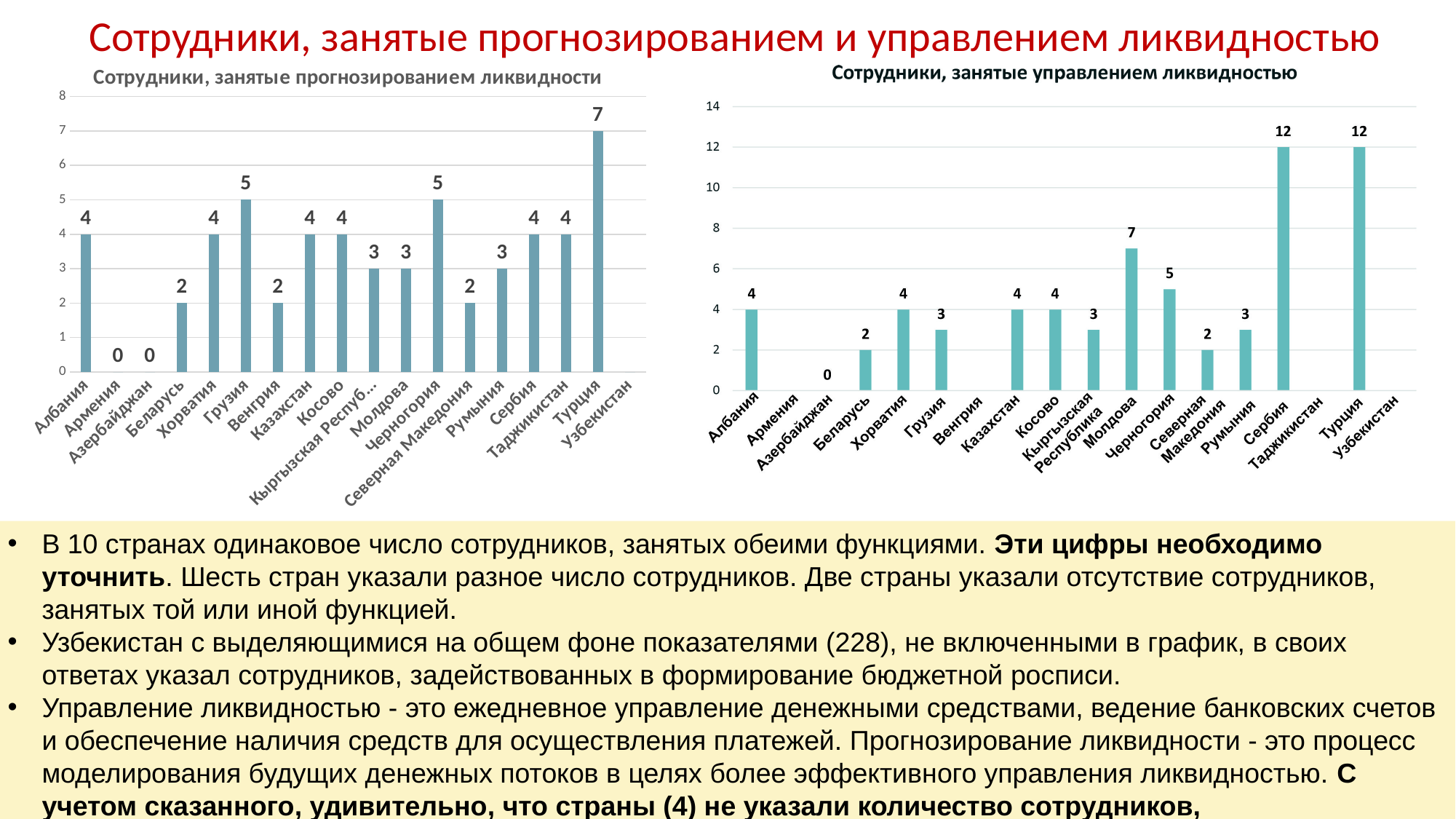
In the chart 'Сотрудники, занятые прогнозированием ликвидности', which country has the highest value? Турция In the chart 'Сотрудники, занятые управлением ликвидностью', what is the difference between the values for Турция and Черногория? 7 How many countries are listed on the x axis of the chart 'Сотрудники, занятые управлением ликвидностью'? 18 In the chart 'Сотрудники, занятые прогнозированием ликвидности', what is the value for Грузия? 5 In the chart 'Сотрудники, занятые прогнозированием ликвидности', which is larger: the value for Беларусь or the value for Молдова? Молдова What type of chart is 'Сотрудники, занятые управлением ликвидностью'? Bar chart In the chart 'Сотрудники, занятые управлением ликвидностью', what is the value for Молдова? 7 In the chart 'Сотрудники, занятые управлением ликвидностью', what is the value for Сербия? 12 In the chart 'Сотрудники, занятые управлением ликвидностью', which is larger: the value for Грузия or the value for Хорватия? Хорватия In the chart 'Сотрудники, занятые управлением ликвидностью', what is the value for Азербайджан? 0 In the chart 'Сотрудники, занятые прогнозированием ликвидности', what is the difference between the values for Турция and Черногория? 2 In the chart 'Сотрудники, занятые прогнозированием ликвидности', what is the value for Турция? 7